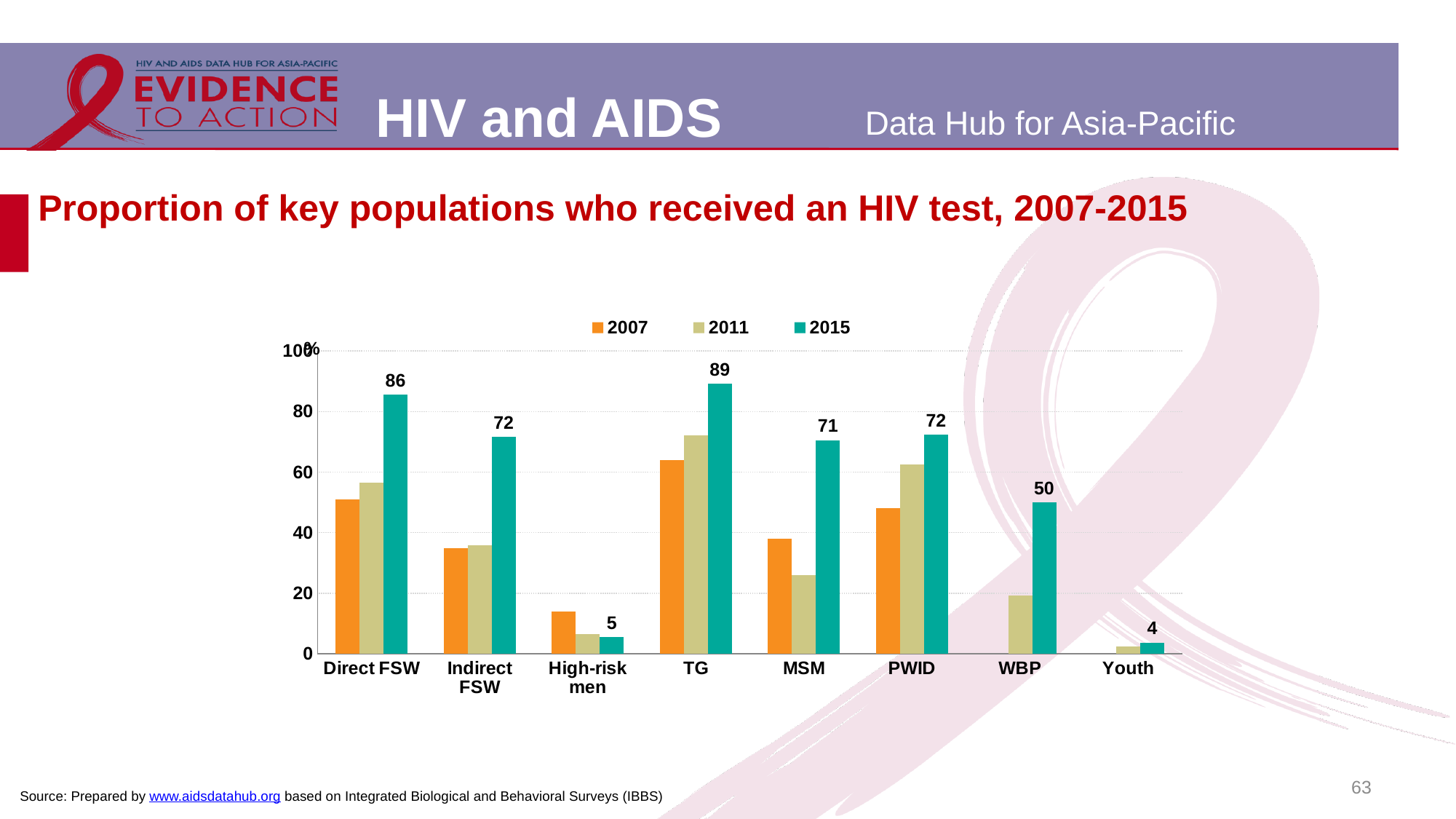
Which is larger, the 2015 value for Direct FSW or the 2015 value for Indirect FSW? Direct FSW What is the 2015 value for TG? 89 How many key population categories are shown on the x axis? 8 Is the 2007 value for Direct FSW greater or less than 40? greater Which key population has the lowest 2015 value? Youth What is the 2015 value for WBP? 50 Is the 2011 value for MSM greater or less than 40? less How many series does the legend list? 3 Which key population has the highest 2015 value? TG What is the 2015 value for Youth? 4 What is the difference between the 2015 values for TG and MSM? 18 What is the 2015 value for Direct FSW? 86